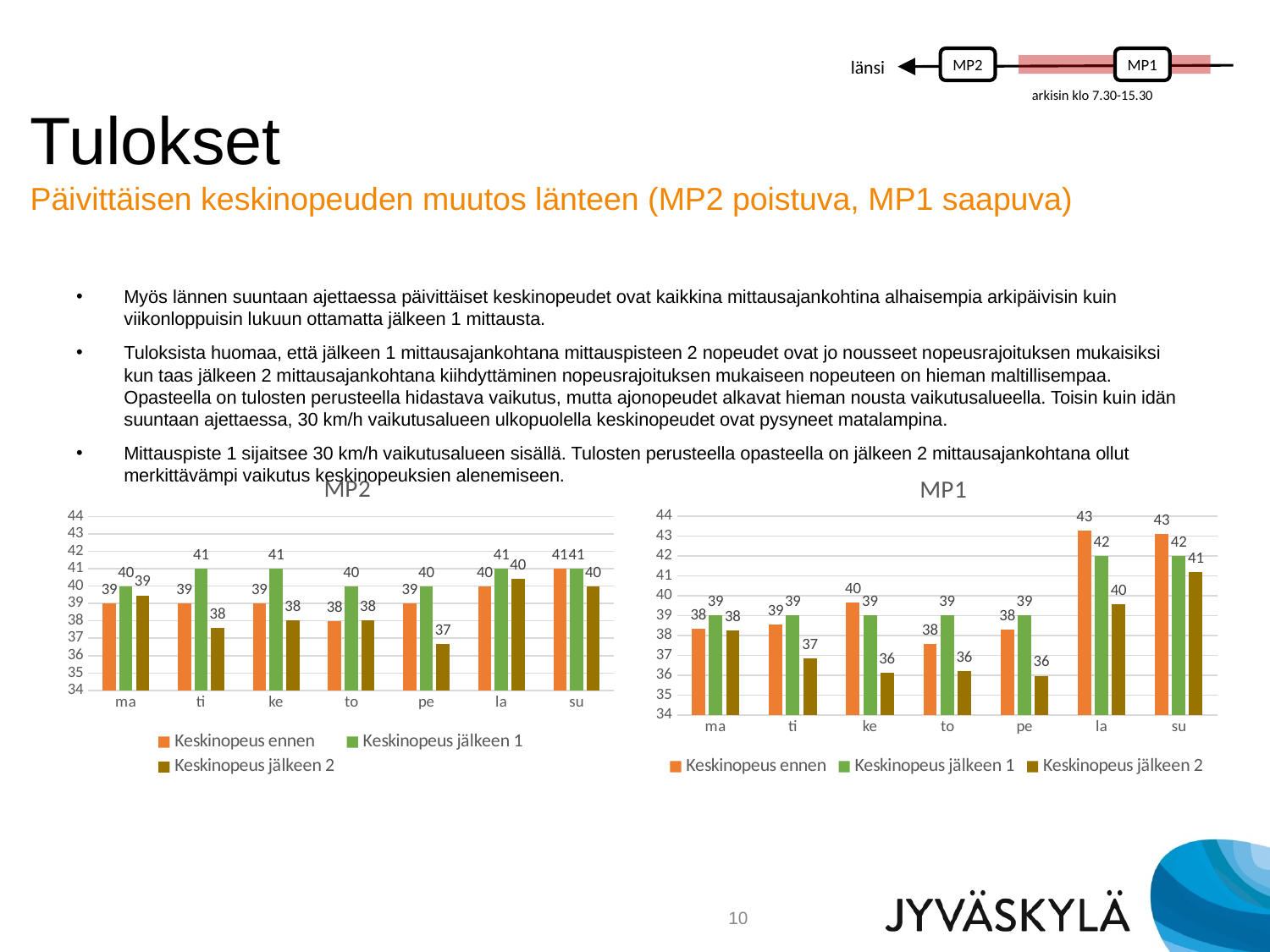
In the MP1 chart, what is the value of Keskinopeus jälkeen 2 for ke? 36 What kind of chart is the MP1 chart? Bar chart In the MP2 chart, which day has the lowest value for Keskinopeus jälkeen 2? pe In the MP2 chart, what is the value of Keskinopeus jälkeen 1 for ti? 41 How many days are shown on the x axis of the MP1 chart? 7 In the MP1 chart, what is the difference between Keskinopeus ennen and Keskinopeus jälkeen 2 for la? 3 In the MP2 chart, what is the difference between Keskinopeus ennen and Keskinopeus jälkeen 2 for pe? 2 In the MP1 chart, which day has the highest value for Keskinopeus jälkeen 2? su In the MP2 chart, which day has the highest value for Keskinopeus ennen? su How many series does the legend of the MP2 chart list? 3 In the MP1 chart, what is the value of Keskinopeus ennen for la? 43 In the MP1 chart, which is larger for ke: Keskinopeus ennen or Keskinopeus jälkeen 2? Keskinopeus ennen